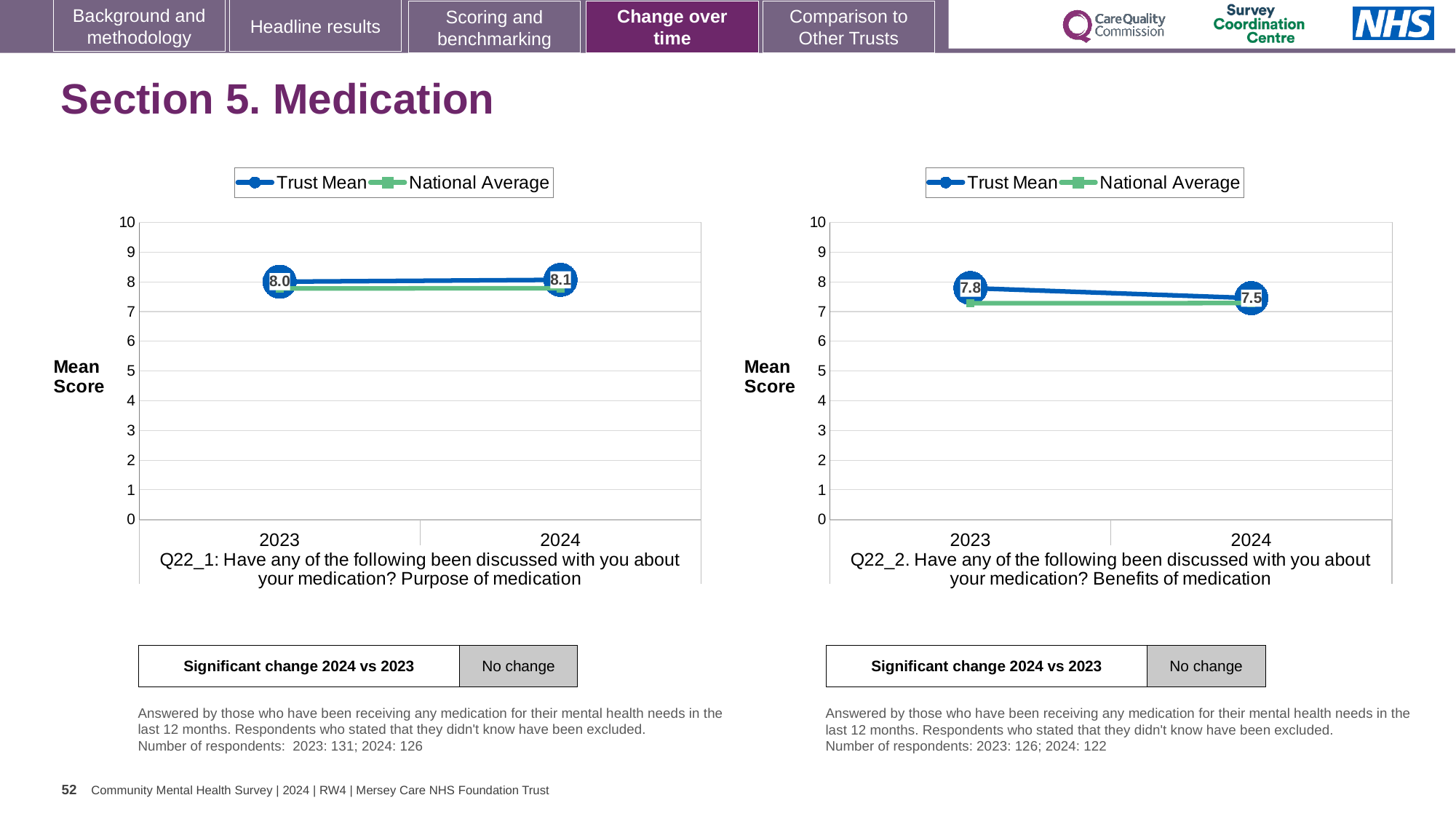
How many years are plotted on the x axis of the left chart (Q22_1: Purpose of medication)? 2 In the left chart (Q22_1: Purpose of medication), does the Trust Mean rise or fall from 2023 to 2024? rise In the left chart (Q22_1: Purpose of medication), what is the Trust Mean for 2023? 8.0 How many series does the legend of the right chart (Q22_2: Benefits of medication) list? 2 In the right chart (Q22_2: Benefits of medication), does the Trust Mean rise or fall from 2023 to 2024? fall In the right chart (Q22_2: Benefits of medication), what is the Trust Mean for 2023? 7.8 In the right chart (Q22_2: Benefits of medication), what is the Trust Mean for 2024? 7.5 In the right chart (Q22_2: Benefits of medication), by how much did the Trust Mean change from 2023 to 2024? 0.3 In the left chart (Q22_1: Purpose of medication), is the Trust Mean for 2024 greater or less than the Trust Mean for 2023? greater In the right chart (Q22_2: Benefits of medication), is the National Average for 2024 greater or less than 8? less What kind of chart is the left chart (Q22_1: Purpose of medication)? line chart In the left chart (Q22_1: Purpose of medication), what is the Trust Mean for 2024? 8.1